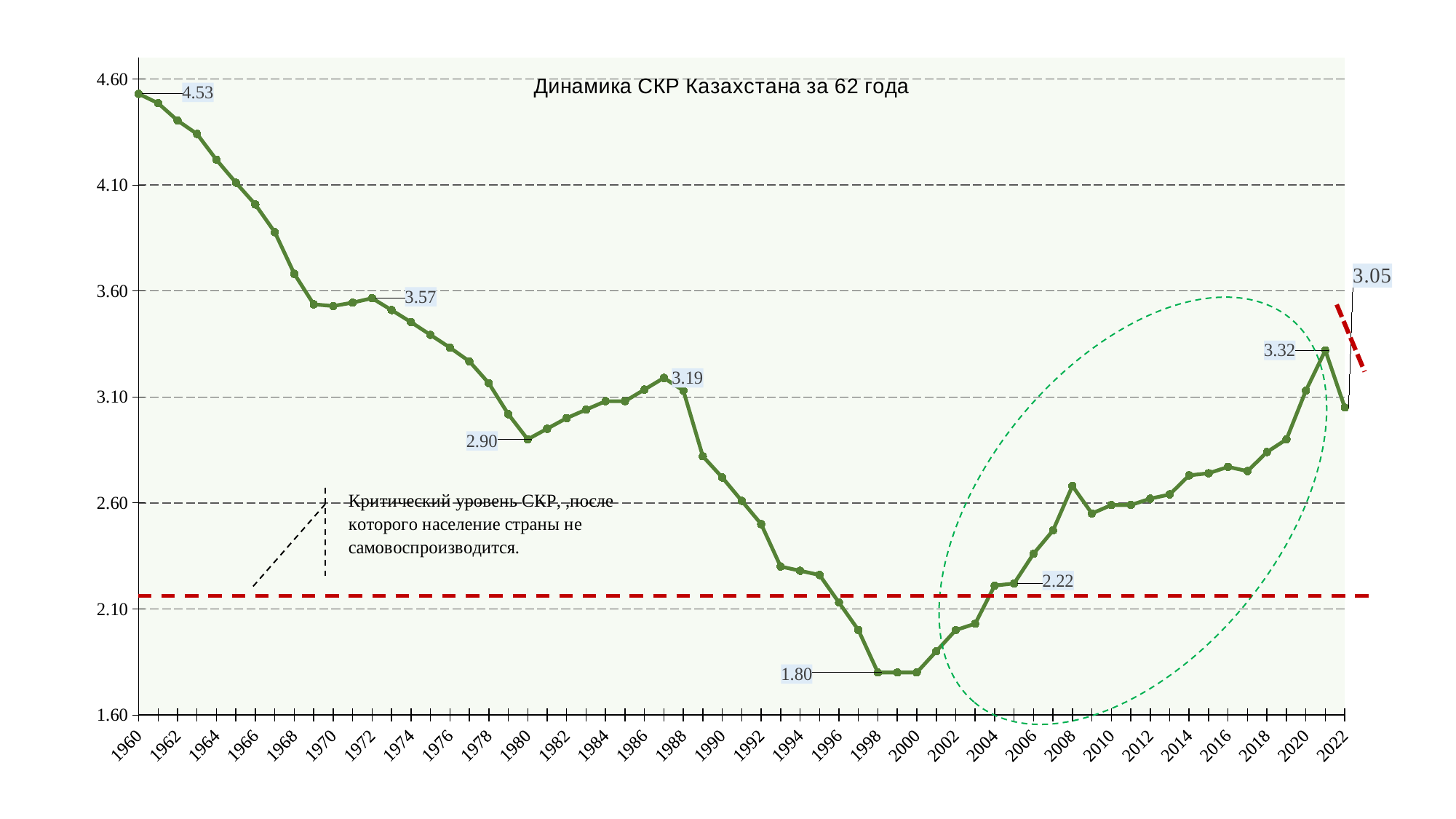
What is the value for 1980? 2.90 What is the value for 1960? 4.53 What is the title of the chart? Динамика СКР Казахстана за 62 года Do the values rise or fall from 1960 to 1969? fall What is the value for 2021? 3.32 Is the value for 1990 greater or less than 2.60? greater What is the value for 2022? 3.05 Which year has the highest value on the chart? 1960 Which is larger, the value for 1960 or the value for 2021? 1960 What is the value for 1998? 1.80 What is the difference between the values for 2021 and 2022? 0.27 What kind of chart is shown on the slide? line chart